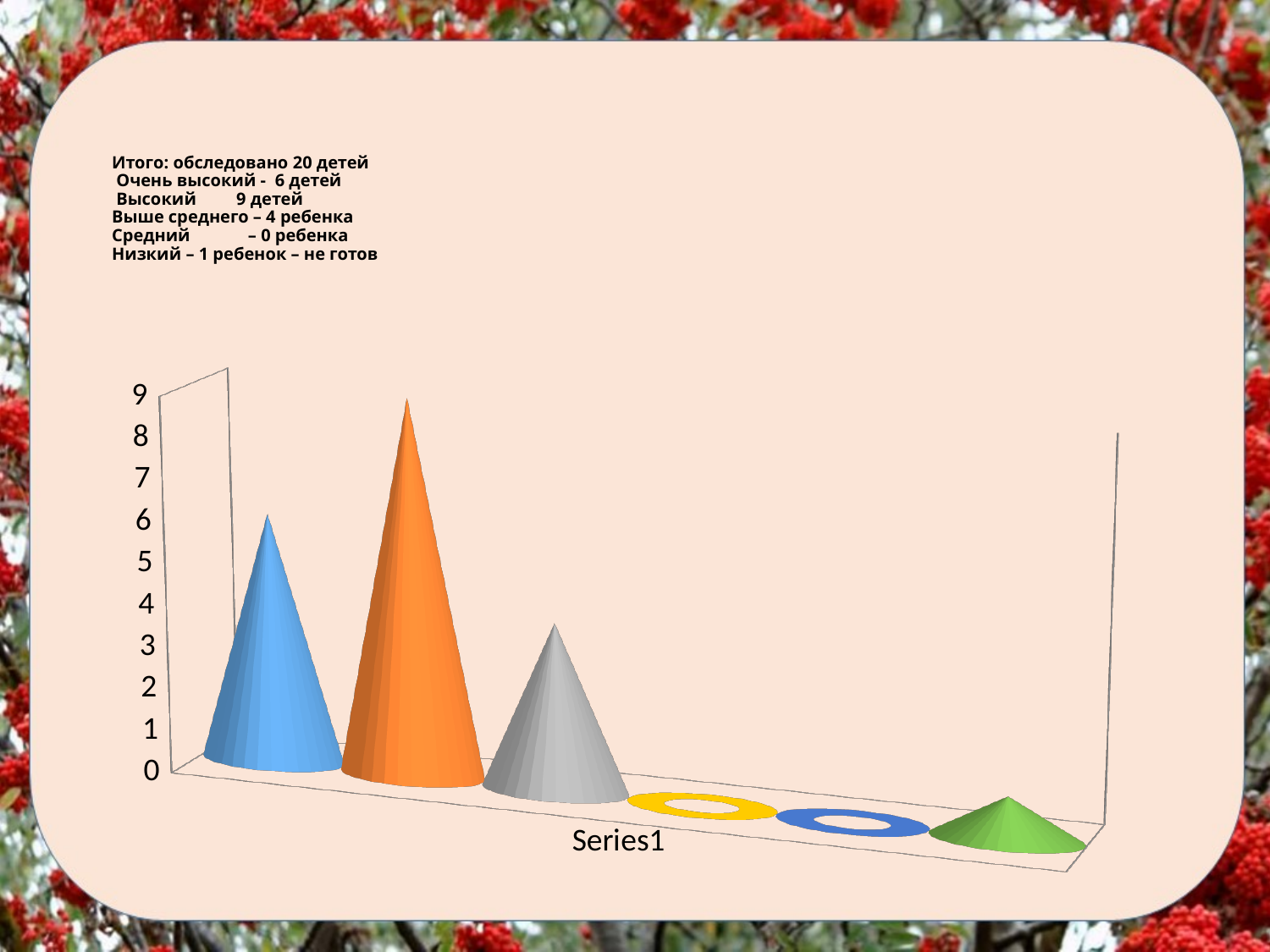
Which is larger, the first blue cone on the left or the gray cone? the first blue cone Is the value of the green cone on the far right greater or less than 2? less What is the category label shown on the x axis of the chart? Series1 What kind of chart is shown on the slide? bar chart Is the value of the first (blue) cone on the left greater or less than 5? greater Is the value of the orange cone greater or less than 8? greater What is the highest value shown on the vertical axis of the chart? 9 How many bars (cones) are plotted in the chart? 6 Which cone is the tallest in the chart? the orange cone (second from left) Which is larger, the orange cone or the first blue cone on the left? the orange cone How many cones in the chart are flat, showing a value of 0? 2